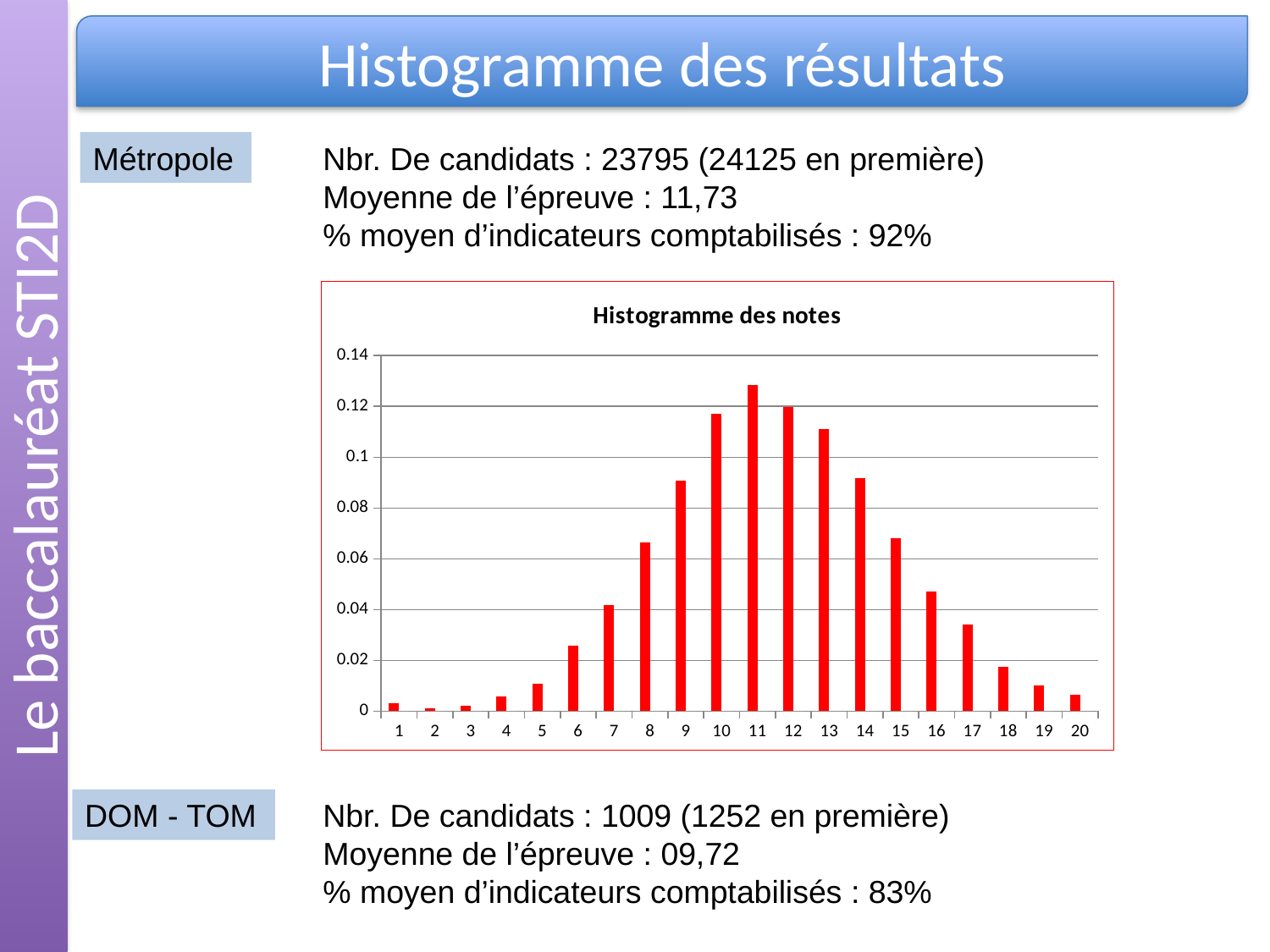
Is the value for category 6 greater or less than 0.02? greater Which category has the lowest bar in the chart? 2 Do the values rise or fall from category 11 to category 20? fall Is the value for category 16 greater or less than 0.06? less How many categories are shown on the x axis of the chart? 20 Which has the larger value, category 6 or category 17? 17 Is the value for category 10 greater or less than 0.1? greater Which has the larger value, category 12 or category 13? 12 Which category has the highest bar in the chart? 11 What kind of chart is shown on the slide? bar chart What is the title of the chart? Histogramme des notes